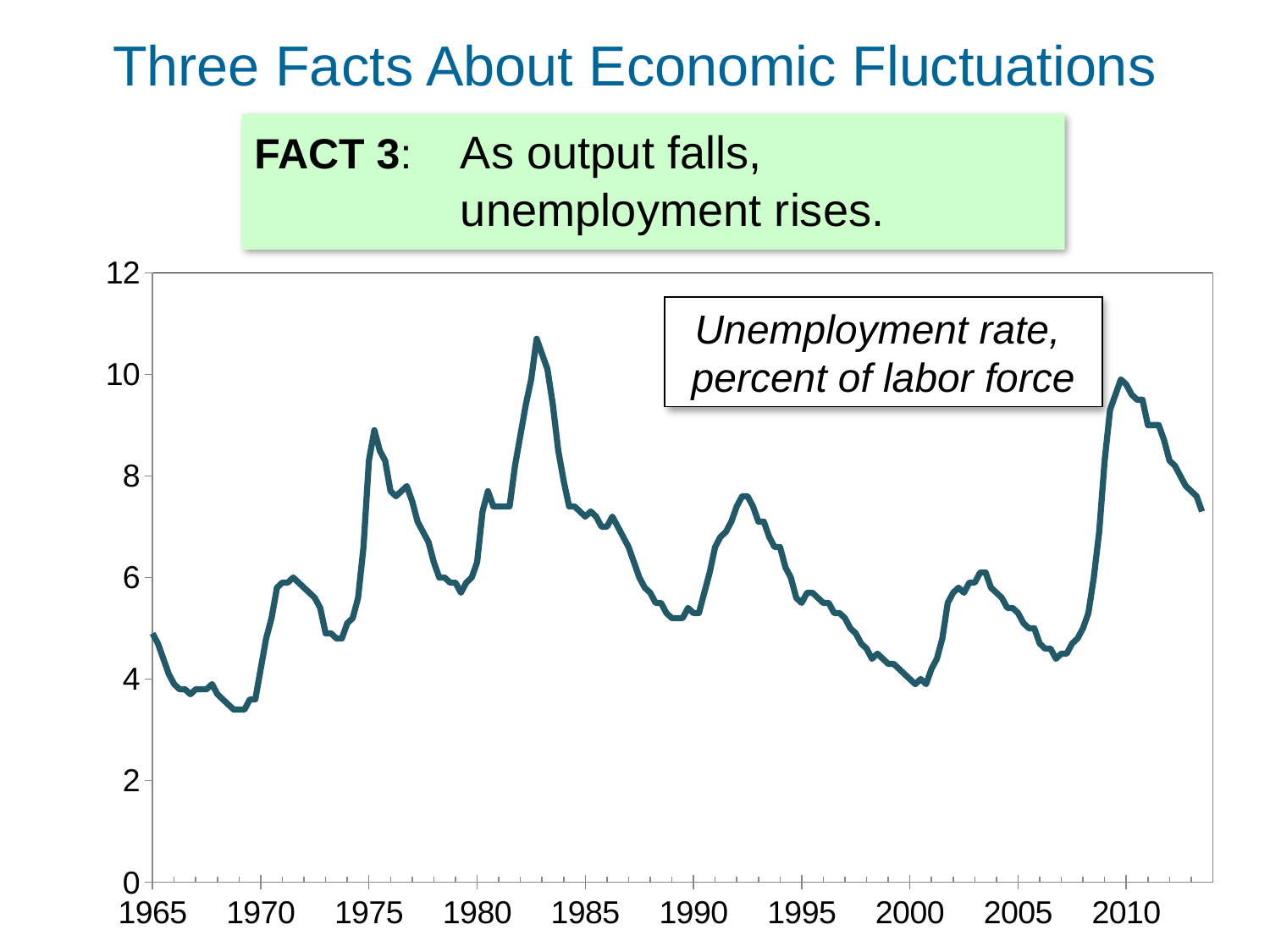
What kind of chart is shown on the slide? line chart Is the peak unemployment rate reached around 1975 greater or less than 8? greater Is the peak unemployment rate reached between 1980 and 1985 greater or less than 10? greater What does the label inside the chart say the line represents? Unemployment rate, percent of labor force How many year labels appear on the horizontal axis? 10 Does the unemployment rate rise or fall between 2010 and the end of the series? fall Which is higher: the peak unemployment rate around 1983 or the peak around 2010? the peak around 1983 Is the lowest unemployment rate reached between 1965 and 1970 greater or less than 4? less What is the highest value shown on the vertical axis? 12 What is the first year labeled on the horizontal axis? 1965 Between which two labeled years does the unemployment rate reach its highest peak? 1980 and 1985 How many data series are plotted on the chart? 1